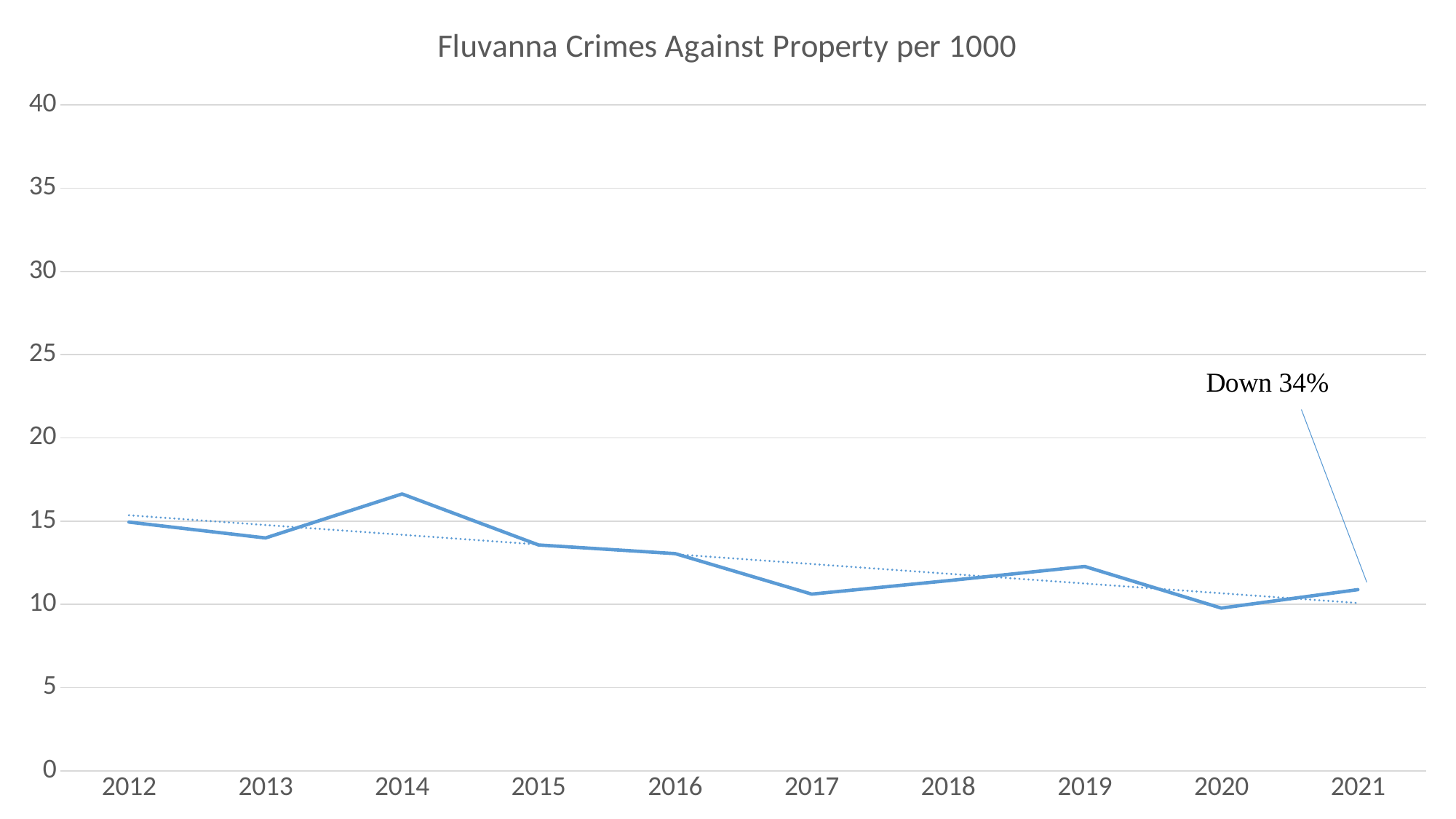
What does the annotation near the 2021 point say? Down 34% Which is larger, the value for 2014 or the value for 2015? 2014 Which year has the lowest value? 2020 How many years are plotted along the x axis? 10 Overall, do the values rise or fall from 2012 to 2021? fall What is the title of the chart? Fluvanna Crimes Against Property per 1000 Is the value for 2014 greater or less than 15? greater What kind of chart is shown on the slide? line chart Is the value for 2016 greater or less than 15? less Which year has the highest value? 2014 Is the value for 2019 greater or less than 10? greater